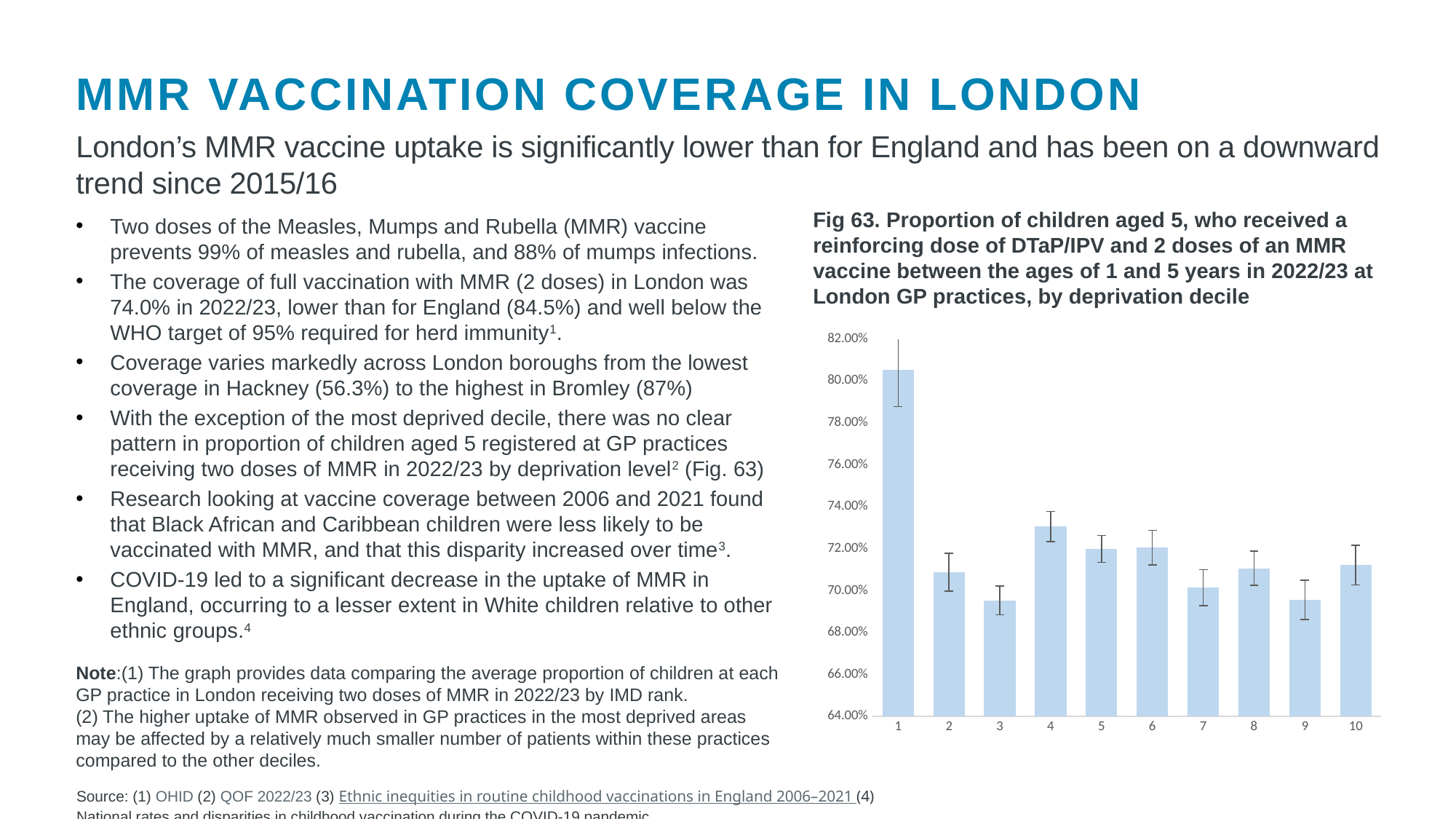
Is the value for decile 2 greater or less than 72.00%? less Is the value for decile 4 greater or less than 72.00%? greater Which deprivation decile has the highest proportion of children receiving the vaccines? 1 How many deprivation deciles are plotted on the x axis of the chart? 10 What is the lowest value shown on the chart's y axis? 64.00% Is the value for decile 7 greater or less than 72.00%? less Which has a higher value, decile 4 or decile 2? decile 4 What is the highest value shown on the chart's y axis? 82.00% Which has a higher value, decile 1 or decile 10? decile 1 What kind of chart is shown in Fig 63? bar chart